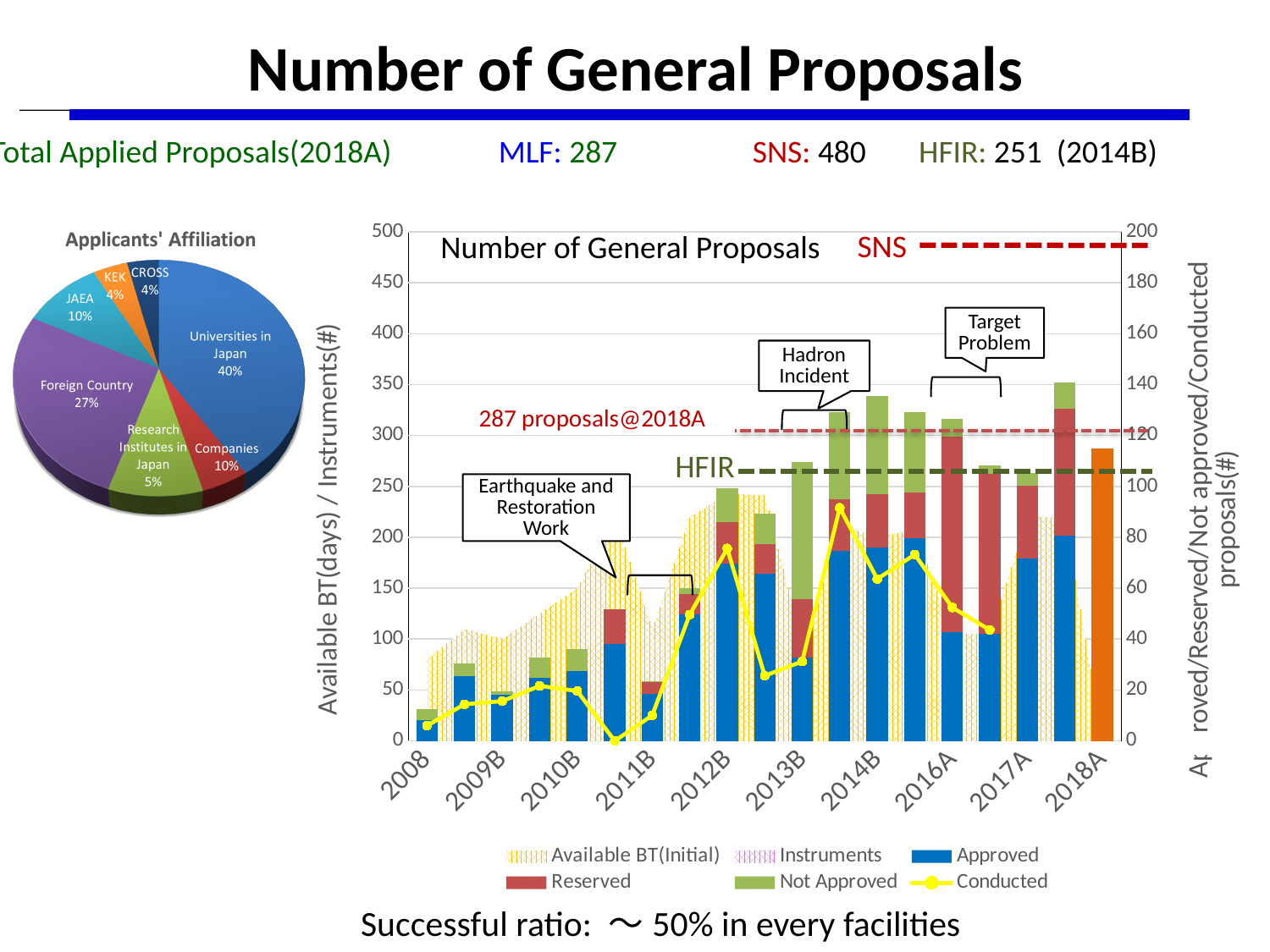
In the Number of General Proposals chart, what is the highest value shown on the left vertical axis? 500 In the Number of General Proposals chart, which series is drawn as a line with markers rather than bars? Conducted In the Applicants' Affiliation pie chart, what is the difference in percentage points between Universities in Japan and Foreign Country? 13 percentage points In the Applicants' Affiliation pie chart, which affiliation has the largest slice? Universities in Japan In the Applicants' Affiliation pie chart, how many slices are there? 7 In the Number of General Proposals chart, how many series does the legend list? 6 In the Applicants' Affiliation pie chart, what share is shown for JAEA? 10% In the Applicants' Affiliation pie chart, what share is shown for Foreign Country? 27% In the Applicants' Affiliation pie chart, which is larger, Foreign Country or Companies? Foreign Country In the Applicants' Affiliation pie chart, what share is shown for Research Institutes in Japan? 5% What kind of chart is the Applicants' Affiliation chart? Pie chart